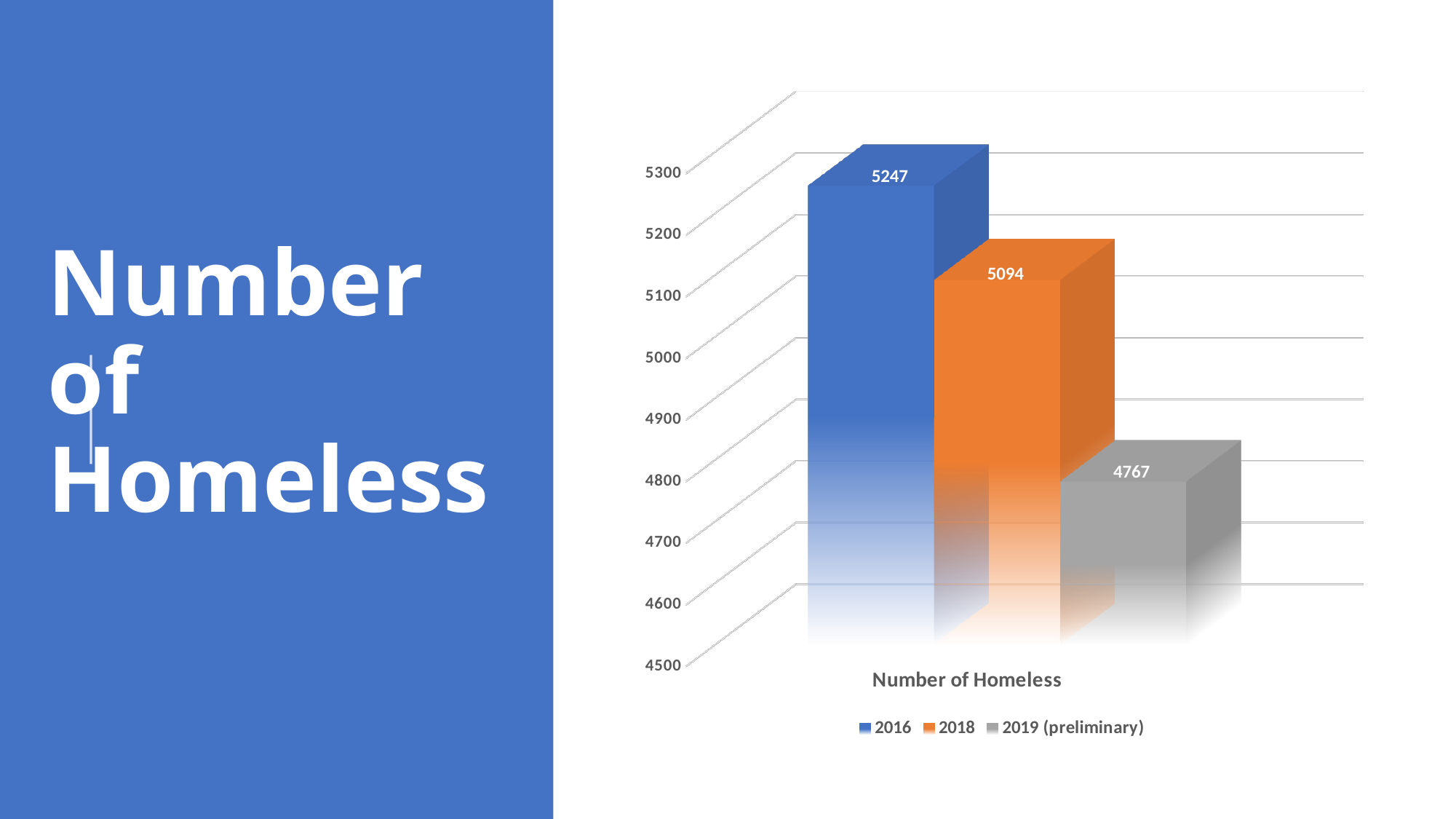
What kind of chart is shown on the slide? bar chart How many series does the legend list? 3 Which series has the highest number of homeless? 2016 What is the difference between the 2018 and 2019 (preliminary) values? 327 What is the number of homeless for 2016? 5247 Which series has the lowest number of homeless? 2019 (preliminary) What is the number of homeless for 2018? 5094 What is the difference between the 2016 and 2018 values? 153 Which is larger, the value for 2016 or the value for 2019 (preliminary)? 2016 What is the category label shown below the bars? Number of Homeless What is the number of homeless for 2019 (preliminary)? 4767 Is the value for 2018 greater or less than 5000? greater